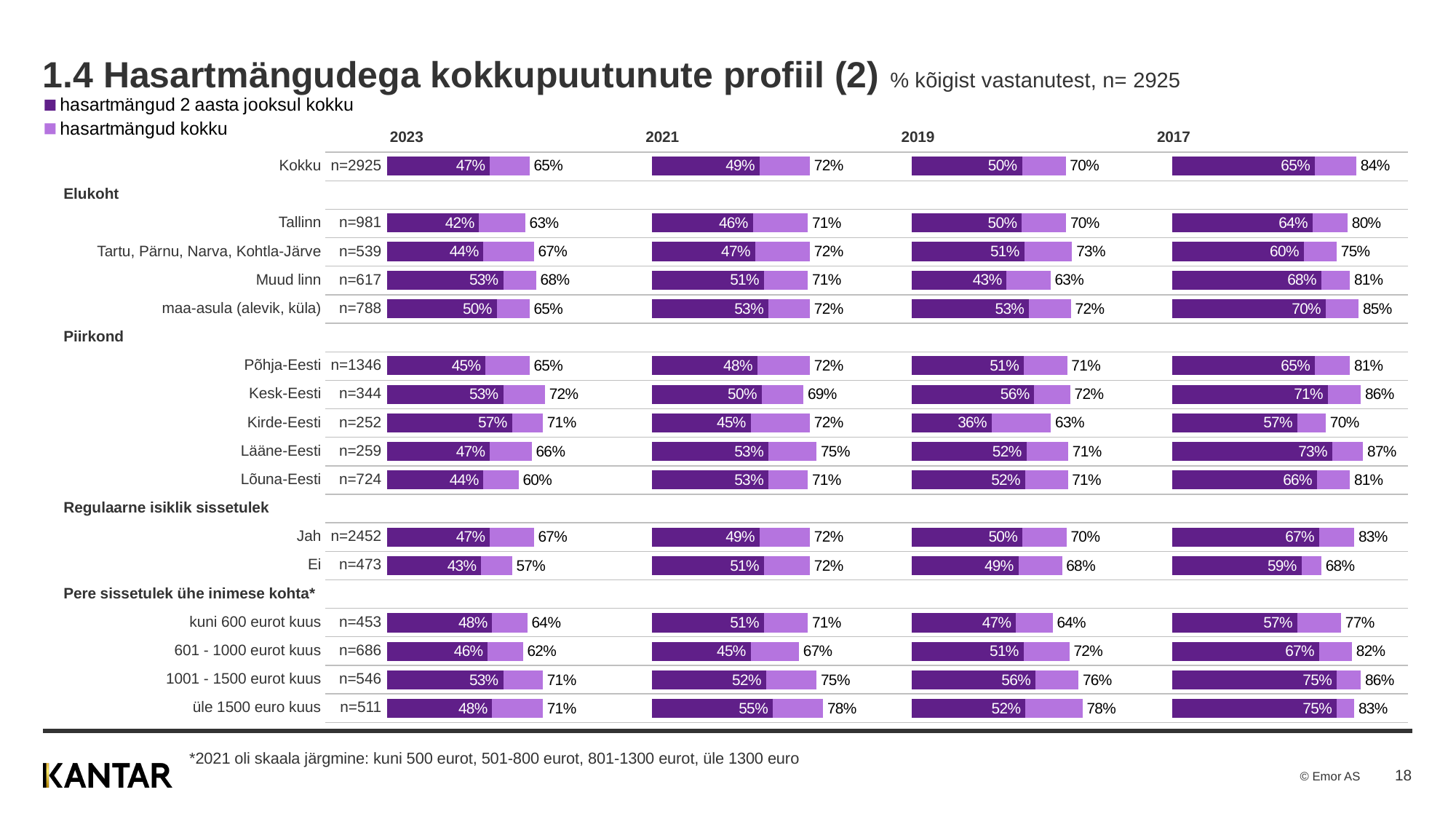
In the 2019 chart, what is the value of 'hasartmängud 2 aasta jooksul kokku' for Kirde-Eesti? 36% In the 2023 chart, which is larger for 'hasartmängud kokku': Jah or Ei (Regulaarne isiklik sissetulek)? Jah In the 2023 chart, what is the value of 'hasartmängud 2 aasta jooksul kokku' for Kokku? 47% In the 2021 chart, what is the value of 'hasartmängud kokku' for 'üle 1500 euro kuus'? 78% What kind of chart is used on this slide? Bar chart How many series does the legend list? 2 In the 2017 chart, what is the difference between the 'hasartmängud kokku' value and the 'hasartmängud 2 aasta jooksul kokku' value for Kokku? 19 percentage points In the 2019 chart, which Piirkond category has the lowest value for 'hasartmängud kokku'? Kirde-Eesti What is the sample size (n) shown for Tallinn? n=981 How many year panels (charts) are shown on the slide? 4 In the 2023 chart, which Piirkond category has the highest value for 'hasartmängud 2 aasta jooksul kokku'? Kirde-Eesti In the 2017 chart, what is the value of 'hasartmängud kokku' for Lääne-Eesti? 87%